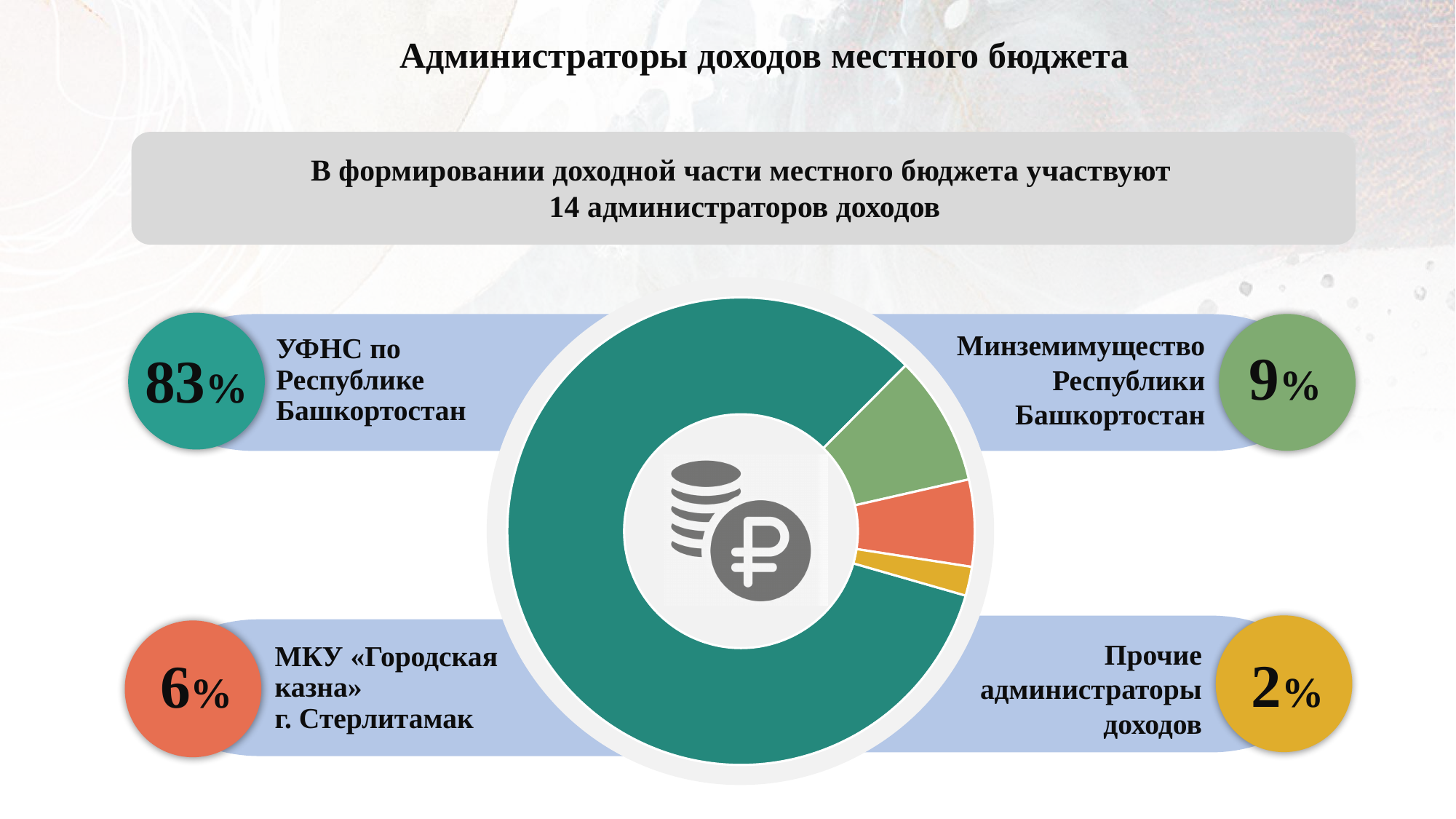
Which revenue administrator has the largest share in the chart? УФНС по Республике Башкортостан According to the slide, how many revenue administrators participate in forming the local budget revenues? 14 What kind of chart is shown on the slide? Donut (pie) chart Which has a larger share: Минземимущество Республики Башкортостан or МКУ «Городская казна» г. Стерлитамак? Минземимущество Республики Башкортостан What share of local budget revenues is administered by УФНС по Республике Башкортостан? 83% What is the difference in percentage points between the share of УФНС по Республике Башкортостан and Минземимущество Республики Башкортостан? 74 Which revenue administrator has the smallest share in the chart? Прочие администраторы доходов What colour is the segment representing МКУ «Городская казна» г. Стерлитамак? Red (orange-red) What share is attributed to Минземимущество Республики Башкортостан? 9% What share is attributed to МКУ «Городская казна» г. Стерлитамак? 6% How many segments does the chart have? 4 What share is attributed to Прочие администраторы доходов? 2%